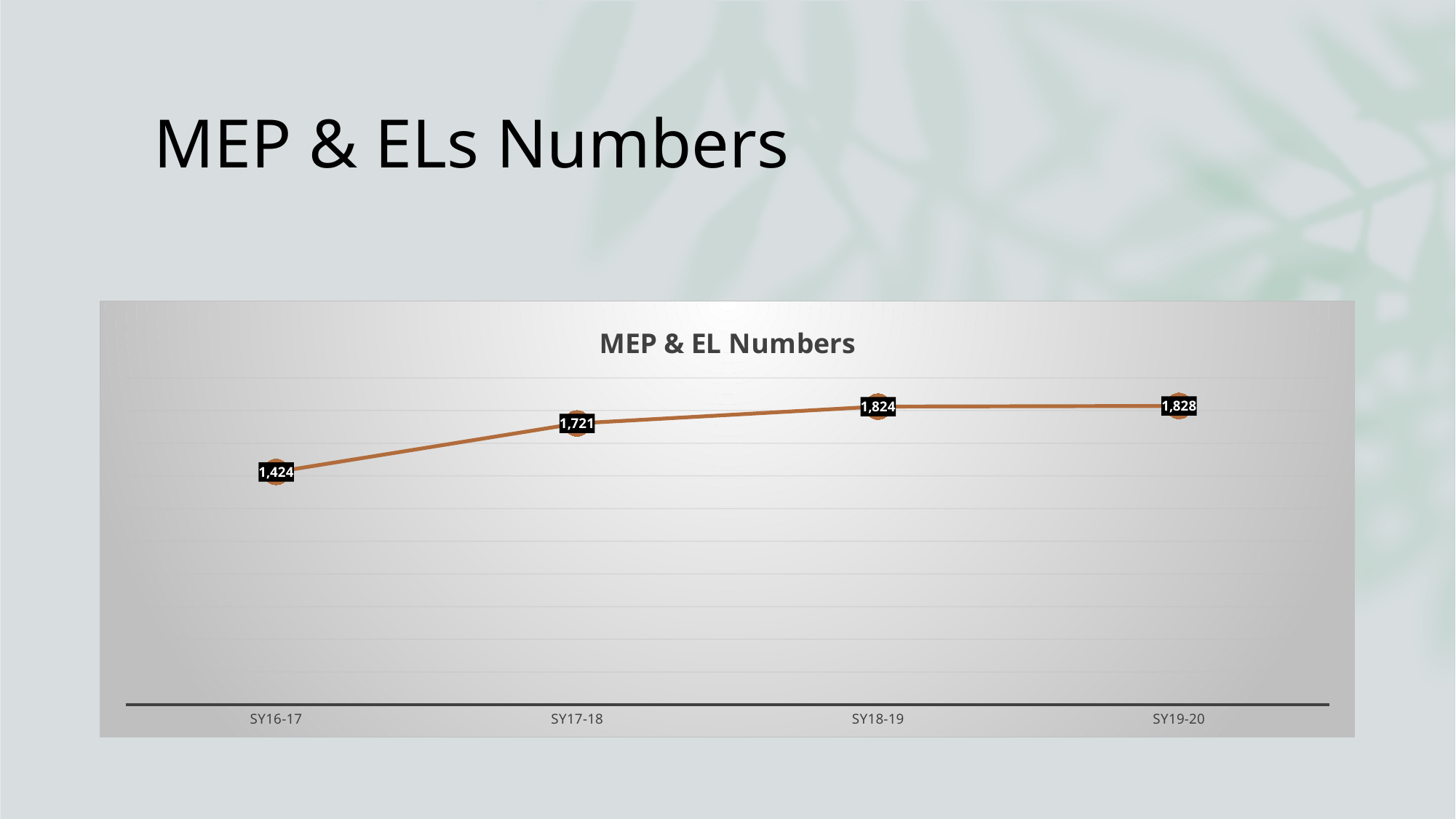
Which school year has the highest value? SY19-20 What is the value for SY17-18? 1,721 Which school year has the lowest value? SY16-17 How many school years are plotted on the chart? 4 What kind of chart is shown on the slide? Line chart What is the value for SY18-19? 1,824 What is the difference between the values for SY19-20 and SY16-17? 404 What is the value for SY16-17? 1,424 Which is larger, the value for SY17-18 or the value for SY18-19? SY18-19 What is the value for SY19-20? 1,828 What is the difference between the values for SY17-18 and SY16-17? 297 Do the values rise or fall from SY16-17 to SY19-20? Rise